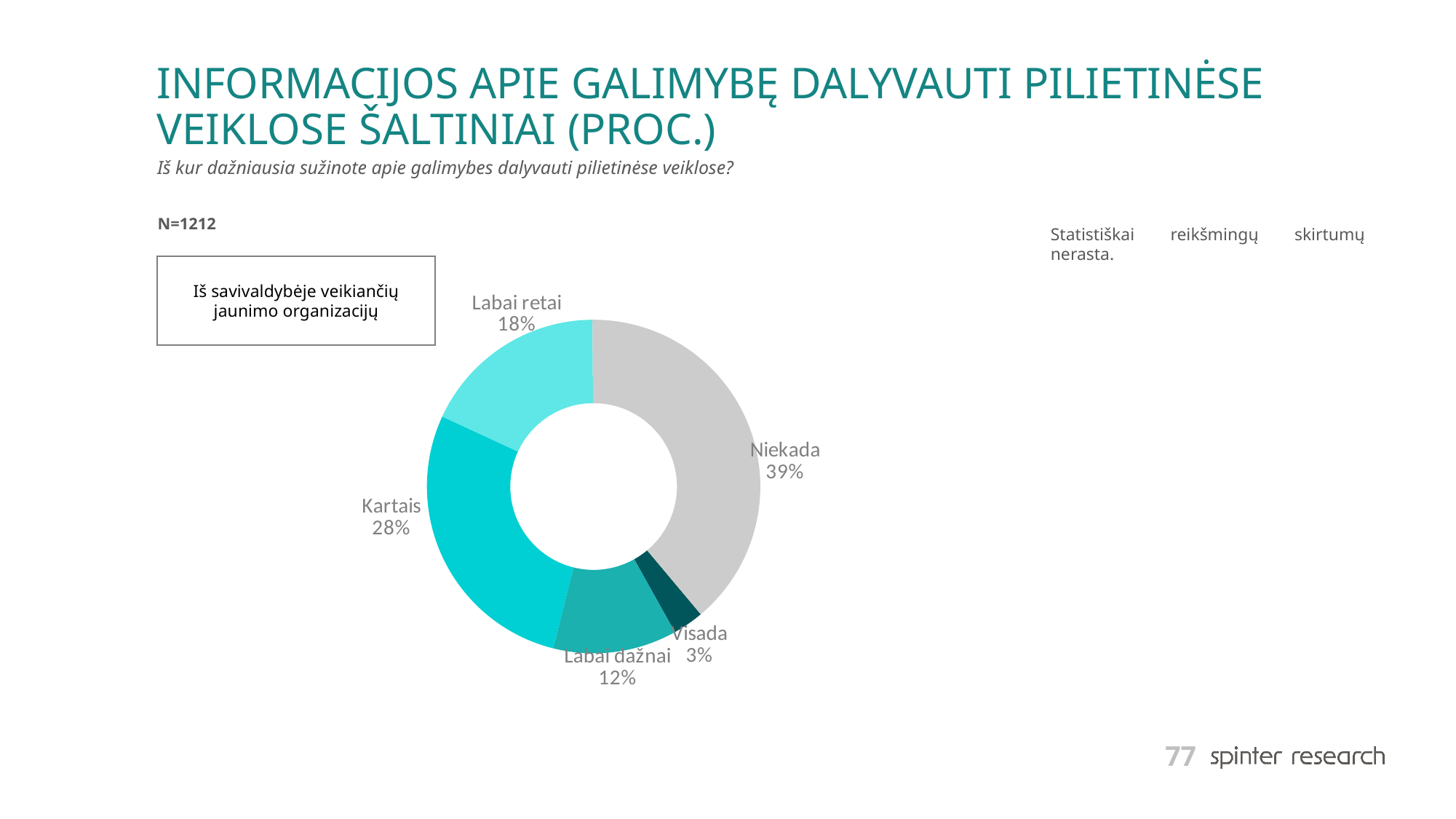
What percentage is shown for "Visada"? 3% What is the difference in percentage points between "Niekada" and "Kartais"? 11 How many categories are shown in the chart? 5 Which category has the largest share of the chart? Niekada Which category has the smallest share of the chart? Visada What percentage is shown for "Niekada"? 39% What percentage is shown for "Kartais"? 28% What is the sample size (N) stated on the slide? N=1212 What percentage is shown for "Labai retai"? 18% What percentage is shown for "Labai dažnai"? 12% What kind of chart is shown on the slide? Pie chart (doughnut) Which is larger, the share for "Labai retai" or the share for "Labai dažnai"? Labai retai